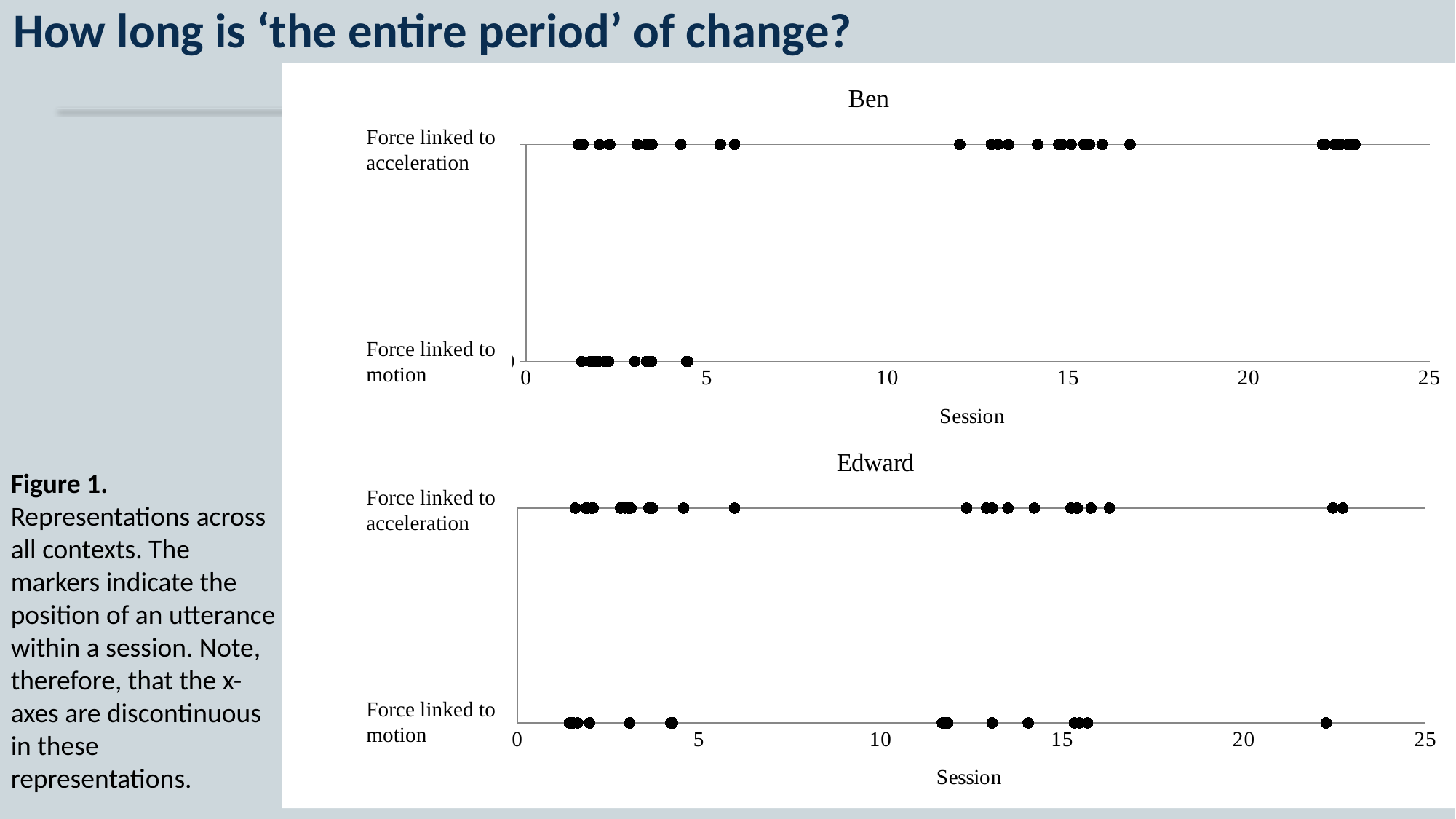
In the Ben chart, which category has markers extending to later sessions, 'Force linked to acceleration' or 'Force linked to motion'? Force linked to acceleration In the Edward chart, is the earliest marker for 'Force linked to acceleration' at a session greater or less than 5? less In the Ben chart, how many categories are plotted on the vertical axis? 2 How many charts are shown on the slide? 2 In the Edward chart, is the latest marker for 'Force linked to motion' at a session greater or less than 20? greater What is the title of the upper chart? Ben In the Ben chart, are the markers for 'Force linked to motion' all at sessions greater or less than 5? less What is the title of the lower chart? Edward In the Edward chart, what is the label of the horizontal axis? Session What kind of chart is the chart titled 'Ben'? scatter chart In the Ben chart, what is the highest tick value shown on the horizontal axis? 25